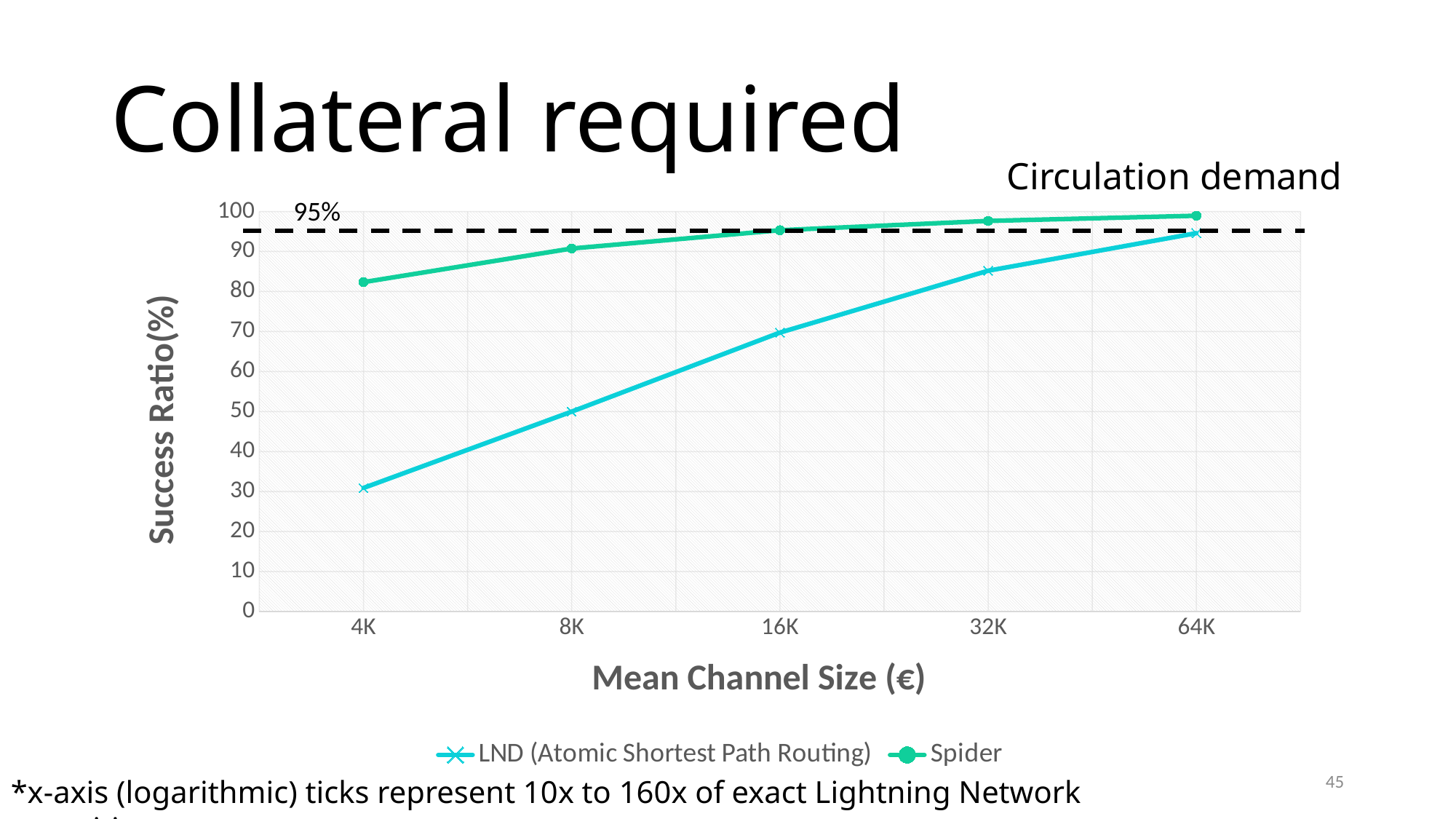
What value does the dashed horizontal line mark? 95% At a mean channel size of 4K, which series has the higher success ratio, LND or Spider? Spider Is the success ratio for Spider at 4K greater or less than 70? greater At which mean channel size is the LND (Atomic Shortest Path Routing) success ratio lowest? 4K What is the title of the x axis? Mean Channel Size (€) What kind of chart is shown on the slide? line chart Does the success ratio for LND (Atomic Shortest Path Routing) rise or fall as mean channel size increases? rise Is the success ratio for LND (Atomic Shortest Path Routing) at 16K greater or less than 60? greater Does the success ratio for Spider rise or fall as mean channel size increases? rise How many series does the legend list? 2 Is the success ratio for LND (Atomic Shortest Path Routing) at 4K greater or less than 40? less How many mean channel size values are plotted along the x axis? 5